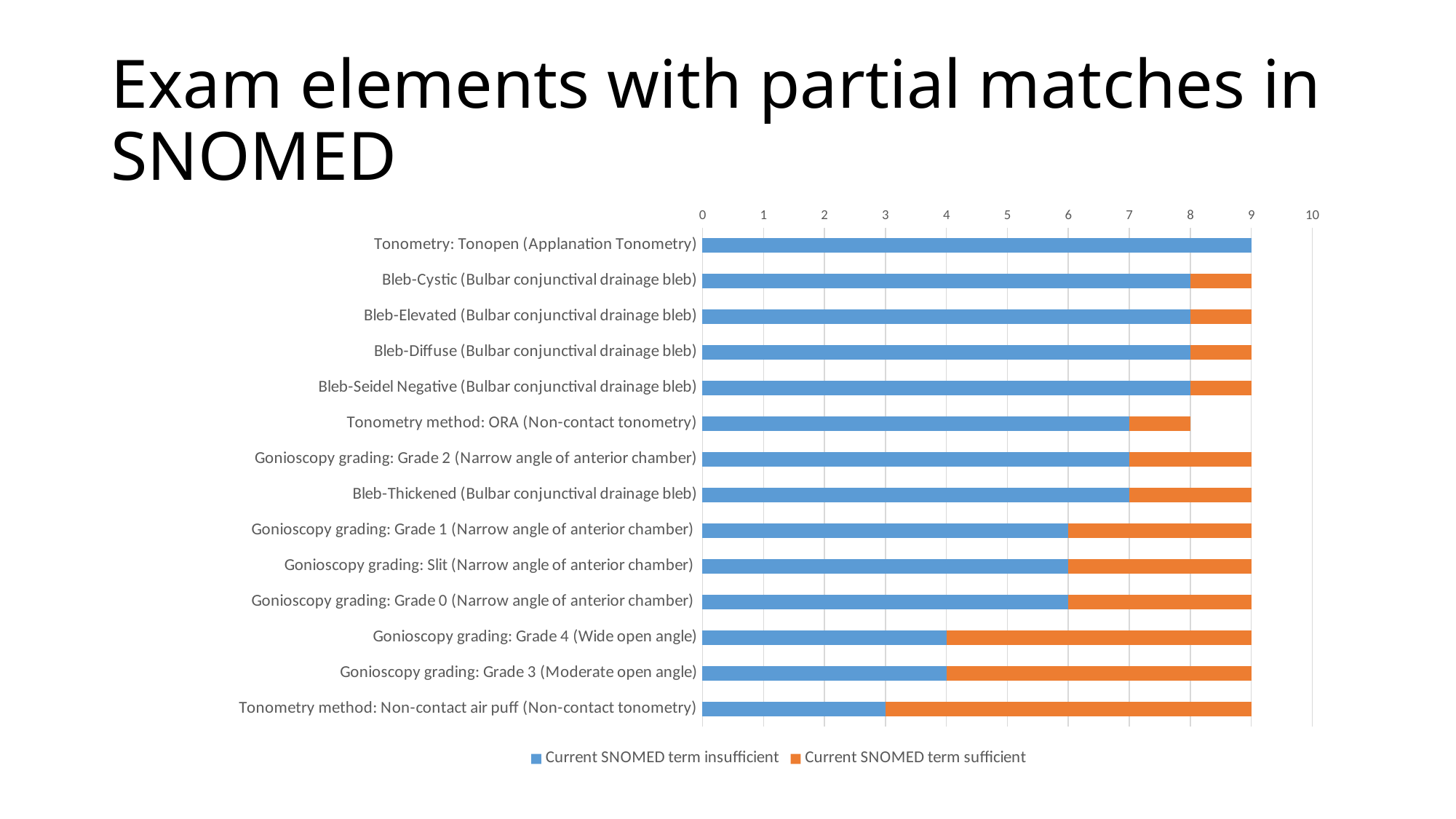
Which colour represents 'Current SNOMED term sufficient' in the chart? Orange What is the 'Current SNOMED term insufficient' value for Tonometry method: Non-contact air puff (Non-contact tonometry)? 3 What is the 'Current SNOMED term sufficient' value for Gonioscopy grading: Grade 4 (Wide open angle)? 5 Which is larger: the 'Current SNOMED term insufficient' value for Gonioscopy grading: Grade 1 (Narrow angle of anterior chamber) or for Gonioscopy grading: Grade 4 (Wide open angle)? Gonioscopy grading: Grade 1 (Narrow angle of anterior chamber) How many series does the legend list? 2 What is the total bar length for Tonometry method: ORA (Non-contact tonometry)? 8 What kind of chart is shown on the slide? Stacked bar chart What is the difference between the 'Current SNOMED term insufficient' values for Bleb-Cystic (Bulbar conjunctival drainage bleb) and Gonioscopy grading: Grade 3 (Moderate open angle)? 4 Which exam element has the highest 'Current SNOMED term sufficient' value? Tonometry method: Non-contact air puff (Non-contact tonometry) Which exam element has the highest 'Current SNOMED term insufficient' value? Tonometry: Tonopen (Applanation Tonometry) How many exam elements (categories) are listed on the chart? 14 What is the 'Current SNOMED term insufficient' value for Tonometry: Tonopen (Applanation Tonometry)? 9